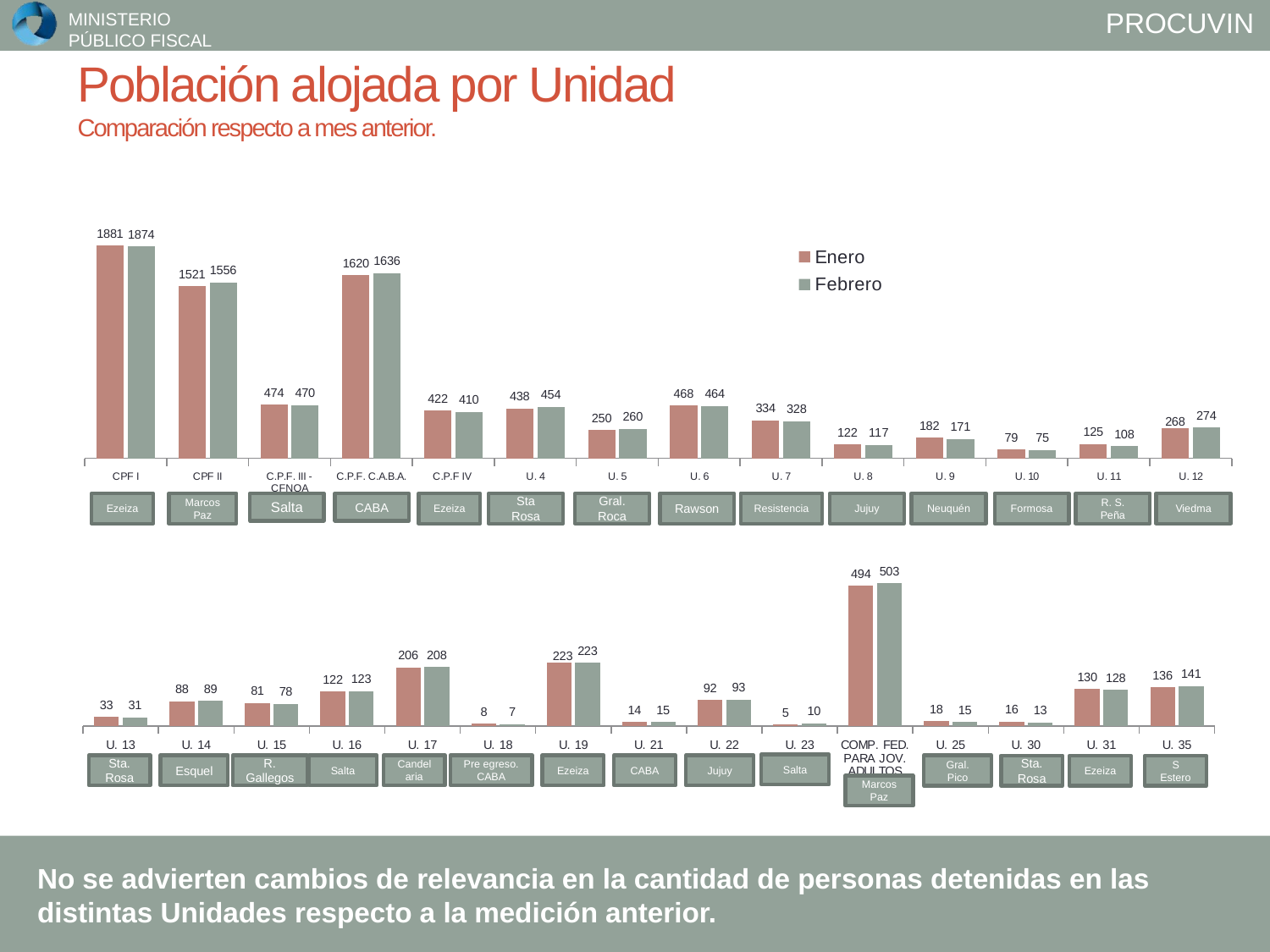
In the bottom chart, which unit has the lowest Enero value? U. 23 In the bottom chart, what is the difference between the Febrero and Enero values for U. 23? 5 In the top chart, which unit has the lowest Febrero value? U. 10 In the top chart, what is the Febrero value for CPF II? 1556 In the top chart, how many units are shown on the x axis? 14 What type of chart is used on this slide? bar chart In the bottom chart, is the Enero value for U. 17 larger or smaller than the Enero value for U. 19? smaller How many series does the legend list? 2 In the top chart, what is the difference between the Enero and Febrero values for U. 11? 17 In the top chart, what is the Enero value for U. 9? 182 In the top chart, which unit has the highest Enero value? CPF I In the bottom chart, what is the Febrero value for COMP. FED. PARA JOV. ADULTOS? 503